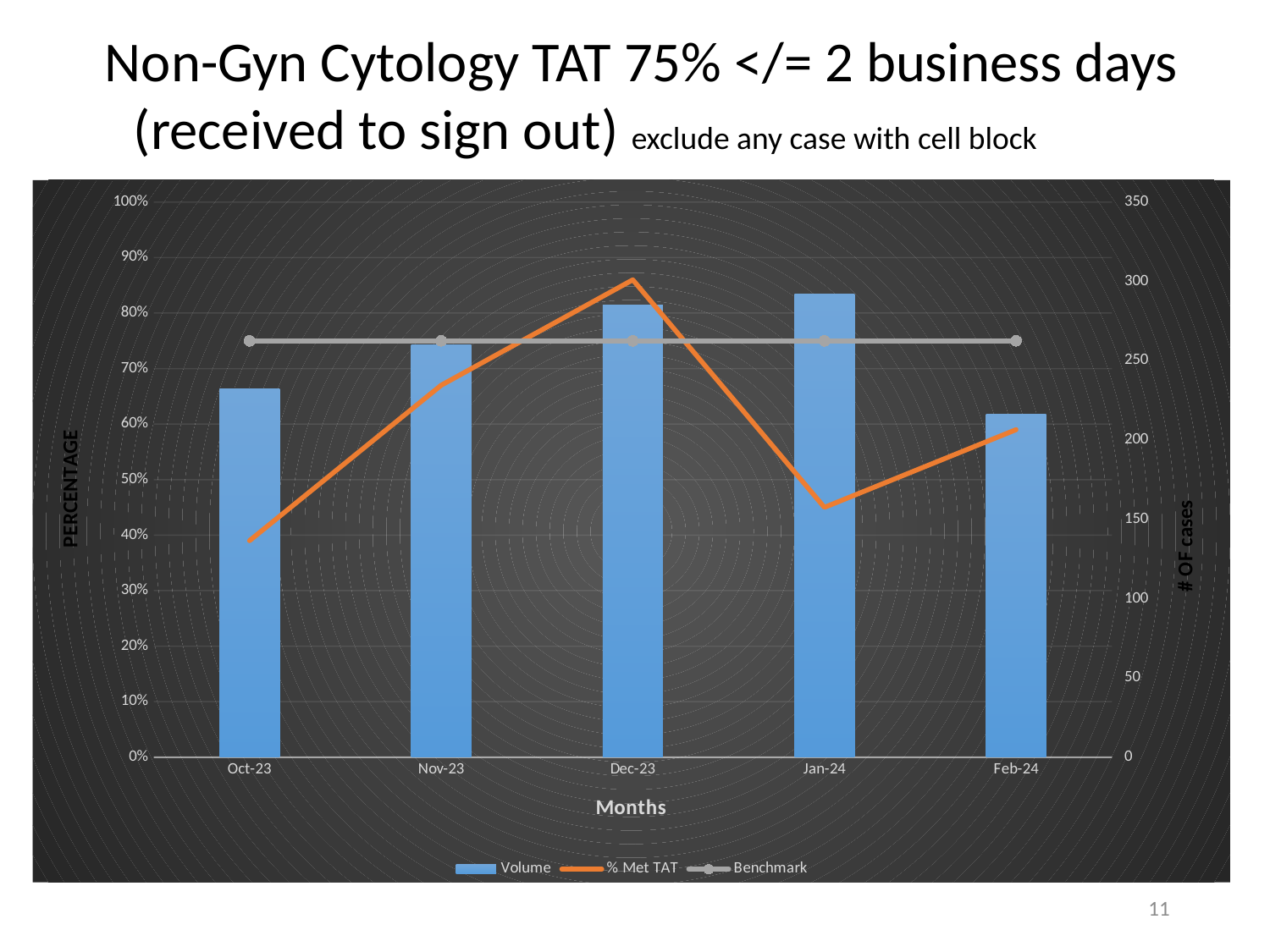
Does the % Met TAT line rise or fall from Oct-23 to Dec-23? rises Is the % Met TAT value for Oct-23 greater or less than 50%? less Which series in the legend is shown as a flat grey line across all months? Benchmark Which month has the lowest Volume bar? Feb-24 In which month is the % Met TAT line at its lowest? Oct-23 Is the % Met TAT value for Dec-23 greater or less than 80%? greater Is the Volume for Feb-24 greater or less than 250 cases? less How many months are shown on the x axis of the chart? 5 How many series does the chart legend list? 3 What kind of chart is used for the Volume series? bar chart In which month is the % Met TAT line at its highest? Dec-23 Which is higher, the % Met TAT for Dec-23 or for Jan-24? Dec-23